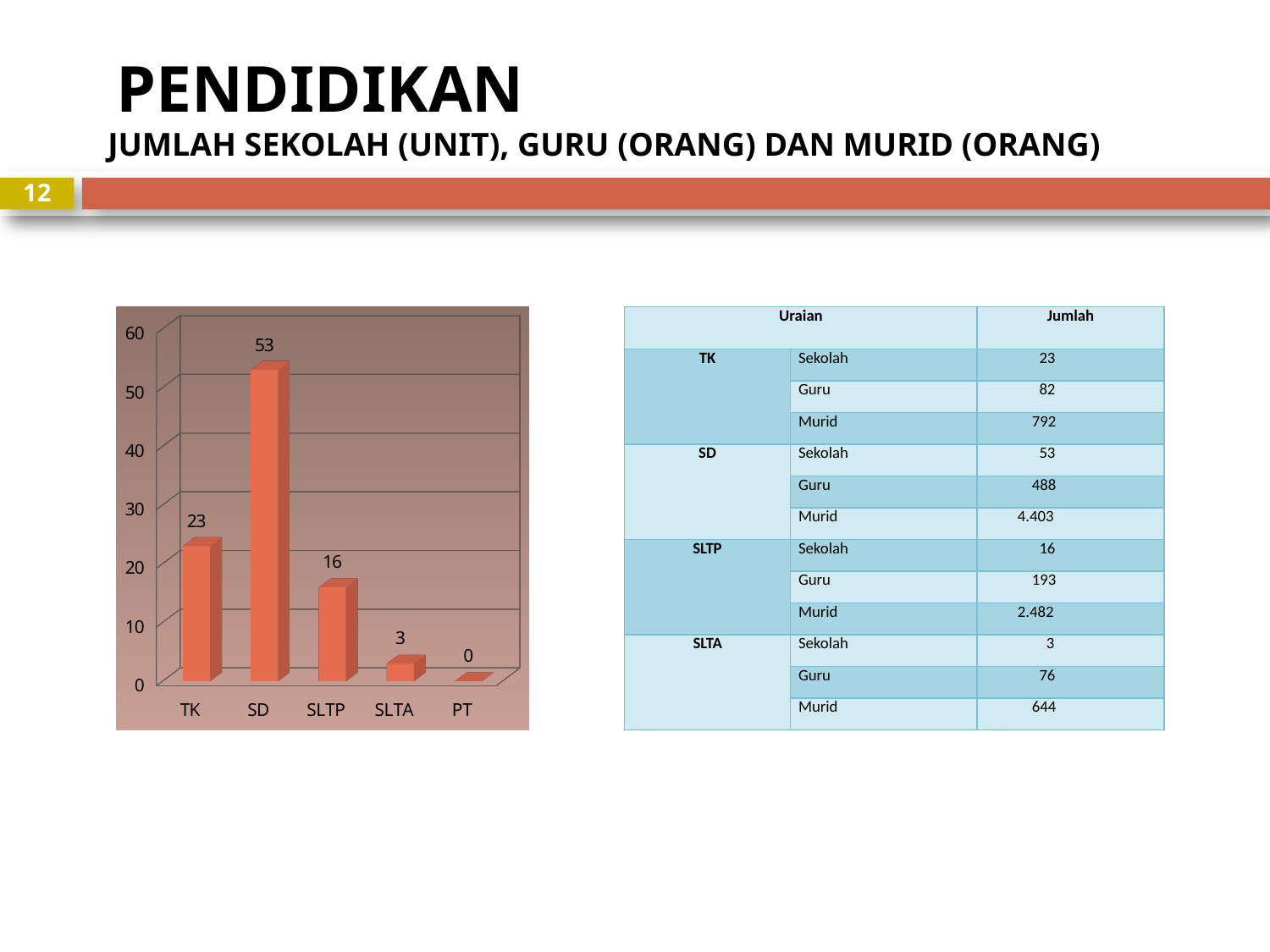
What is the value for TK in the bar chart? 23 What is the value for SLTP in the bar chart? 16 Which category has the highest value in the bar chart? SD Which category has the lowest value in the bar chart? PT What is the value for PT in the bar chart? 0 What is the difference between the values for SLTP and SLTA in the bar chart? 13 How many categories are shown on the x axis of the bar chart? 5 Which is larger in the bar chart, the value for TK or the value for SLTP? TK What is the difference between the values for SD and TK in the bar chart? 30 Is the value for SD in the bar chart greater or less than 50? greater What kind of chart is shown on the slide? bar chart What is the value for SD in the bar chart? 53